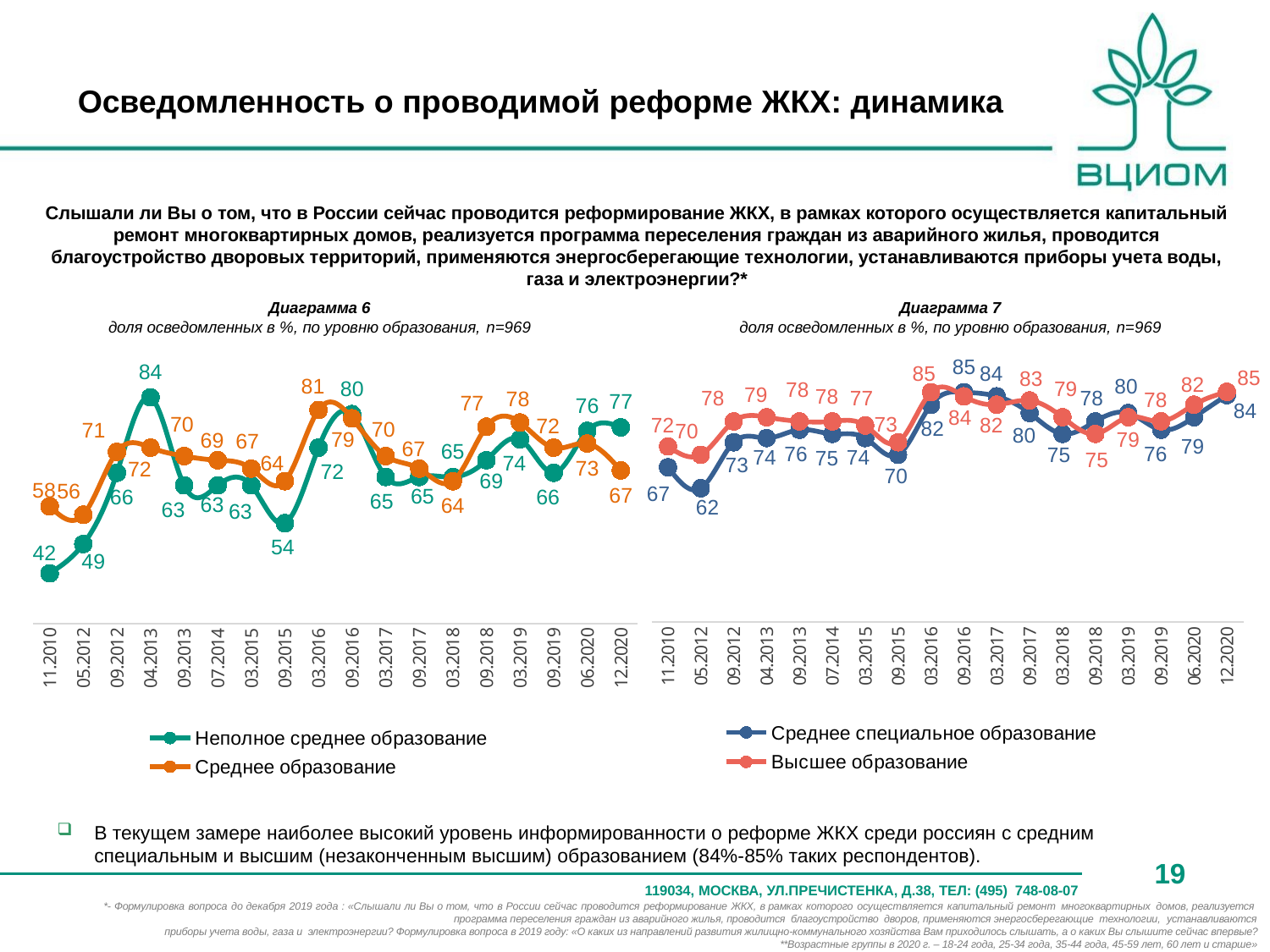
In Диаграмма 7, at which date is Среднее специальное образование at its lowest value? 05.2012 In Диаграмма 6, at which date does Неполное среднее образование reach its highest value? 04.2013 How many series does the legend of Диаграмма 6 list? 2 How many data points does each series in Диаграмма 7 have? 18 In Диаграмма 6, what is the difference between Неполное среднее образование and Среднее образование at 12.2020? 10 In Диаграмма 6, at which date is Среднее образование at its lowest value? 05.2012 In Диаграмма 7, what is the value for Высшее образование at 11.2010? 72 In Диаграмма 7, what is the value for Среднее специальное образование at 09.2016? 85 What type of chart is Диаграмма 6? Line chart In Диаграмма 6, what is the value for Неполное среднее образование at 11.2010? 42 In Диаграмма 6, what is the value for Среднее образование at 03.2016? 81 In Диаграмма 7, which series has the higher value at 03.2018, Среднее специальное образование or Высшее образование? Высшее образование